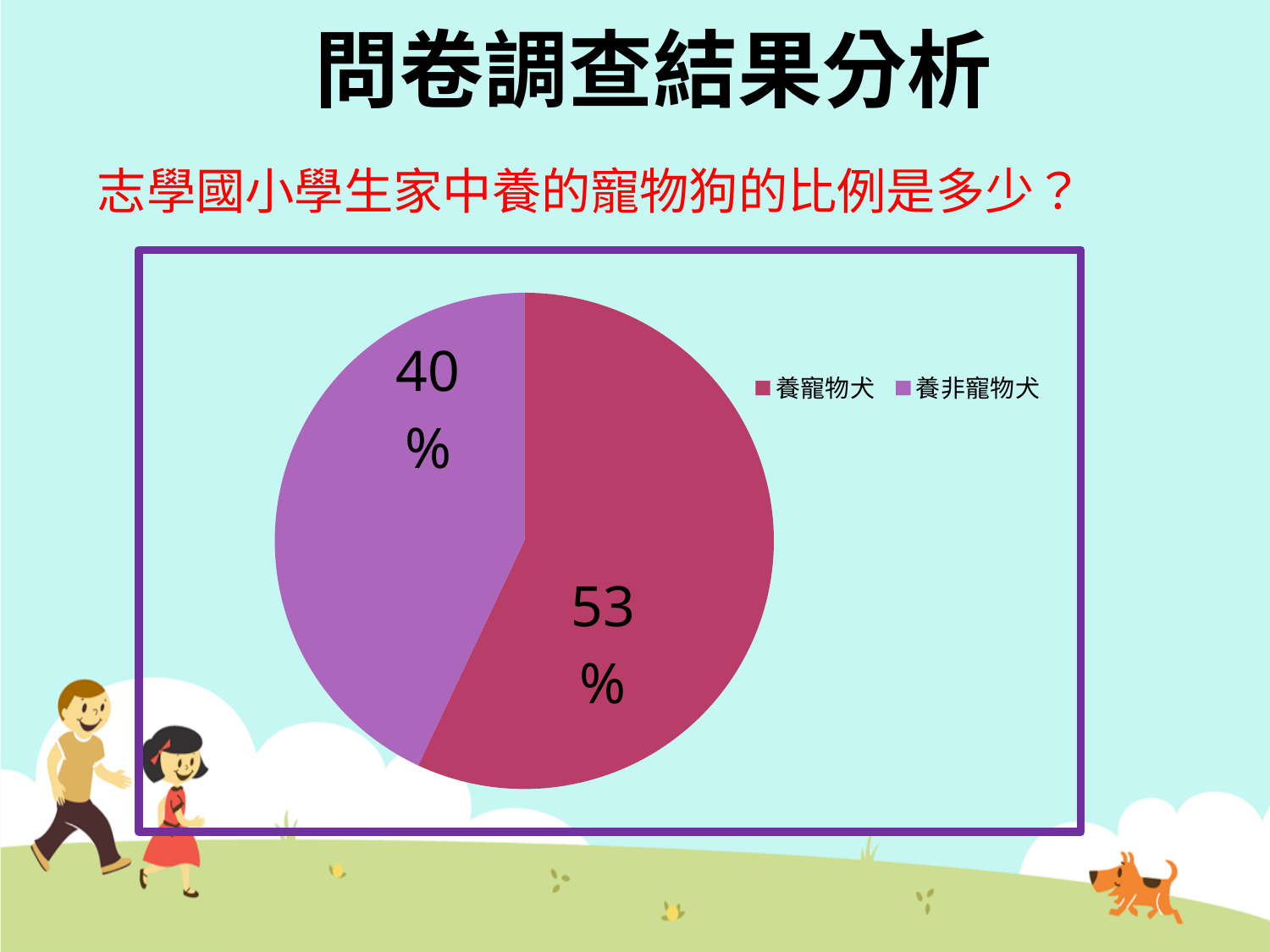
Which category has the largest slice in the pie chart? 養寵物犬 What share of the pie does the 養非寵物犬 slice represent? 40% What percentage is shown for 養寵物犬 in the pie chart? 53% Which category has the smallest slice in the pie chart? 養非寵物犬 Which is larger, the slice for 養寵物犬 or the slice for 養非寵物犬? 養寵物犬 How many slices does the pie chart have? 2 How many entries does the legend list? 2 By how many percentage points does 養寵物犬 exceed 養非寵物犬? 13 Which legend entry is shown in purple? 養非寵物犬 What colour is the 養寵物犬 slice in the pie chart? Red (magenta) What kind of chart is shown on the slide? Pie chart What percentage is shown for 養非寵物犬 in the pie chart? 40%